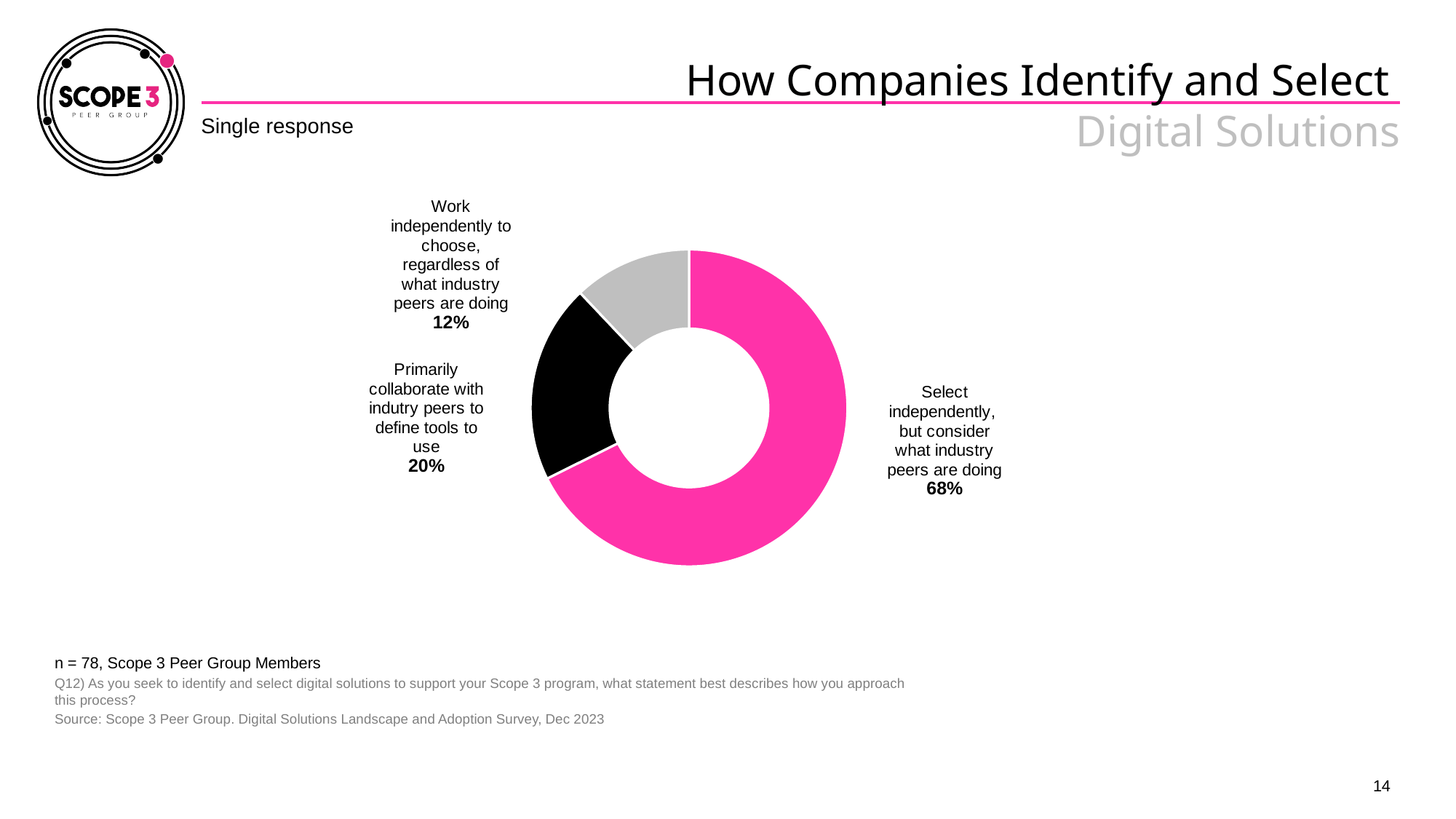
How many respondents (n) does the chart represent? 78 Which is larger: the share for 'Primarily collaborate with industry peers to define tools to use' or the share for 'Work independently to choose, regardless of what industry peers are doing'? Primarily collaborate with industry peers to define tools to use How many response categories are shown in the chart? 3 Which response has the smallest share of the chart? Work independently to choose, regardless of what industry peers are doing What colour is the segment for 'Select independently, but consider what industry peers are doing'? Pink What is the difference in percentage points between 'Select independently, but consider what industry peers are doing' and 'Primarily collaborate with industry peers to define tools to use'? 48 percentage points What percentage of respondents select independently, but consider what industry peers are doing? 68% What is the difference in percentage points between 'Primarily collaborate with industry peers to define tools to use' and 'Work independently to choose, regardless of what industry peers are doing'? 8 percentage points What kind of chart is shown on the slide? Doughnut (pie) chart What percentage of respondents primarily collaborate with industry peers to define tools to use? 20% What percentage of respondents work independently to choose, regardless of what industry peers are doing? 12% Which response has the largest share of the chart? Select independently, but consider what industry peers are doing